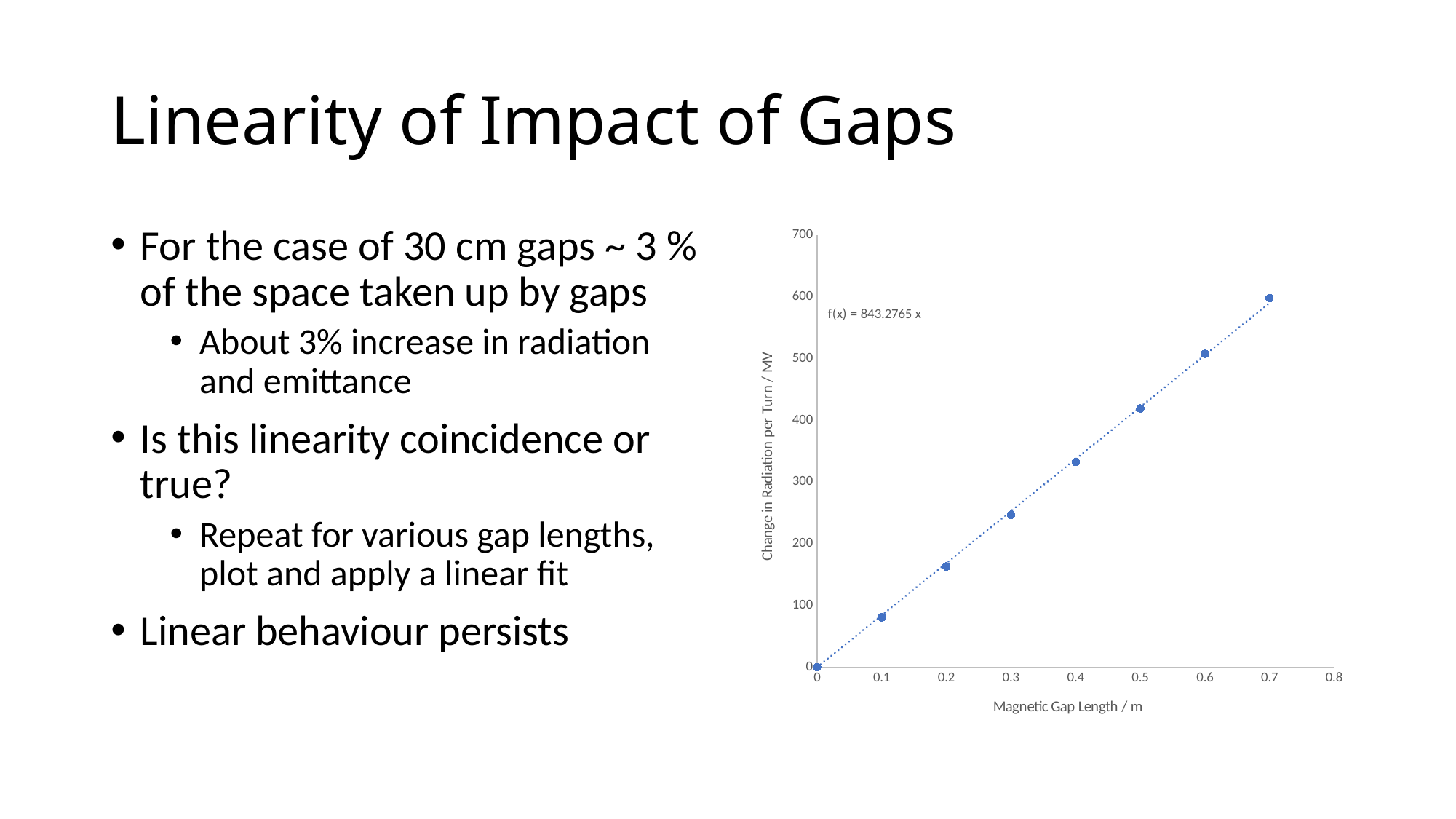
Is the change in radiation per turn at a gap length of 0.7 m greater or less than 500? greater Is the change in radiation per turn at a gap length of 0.2 m greater or less than 200? less At which magnetic gap length is the change in radiation per turn lowest? 0 What kind of chart is shown on the slide? scatter plot Do the plotted values rise or fall as the magnetic gap length increases? rise Which has the larger change in radiation per turn: a gap length of 0.3 m or 0.5 m? 0.5 m What is the equation of the linear fit shown on the chart? f(x) = 843.2765 x At which magnetic gap length is the change in radiation per turn highest? 0.7 What is the label of the x axis? Magnetic Gap Length / m Is the change in radiation per turn at a gap length of 0.1 m greater or less than 100? less How many data points are plotted on the chart? 8